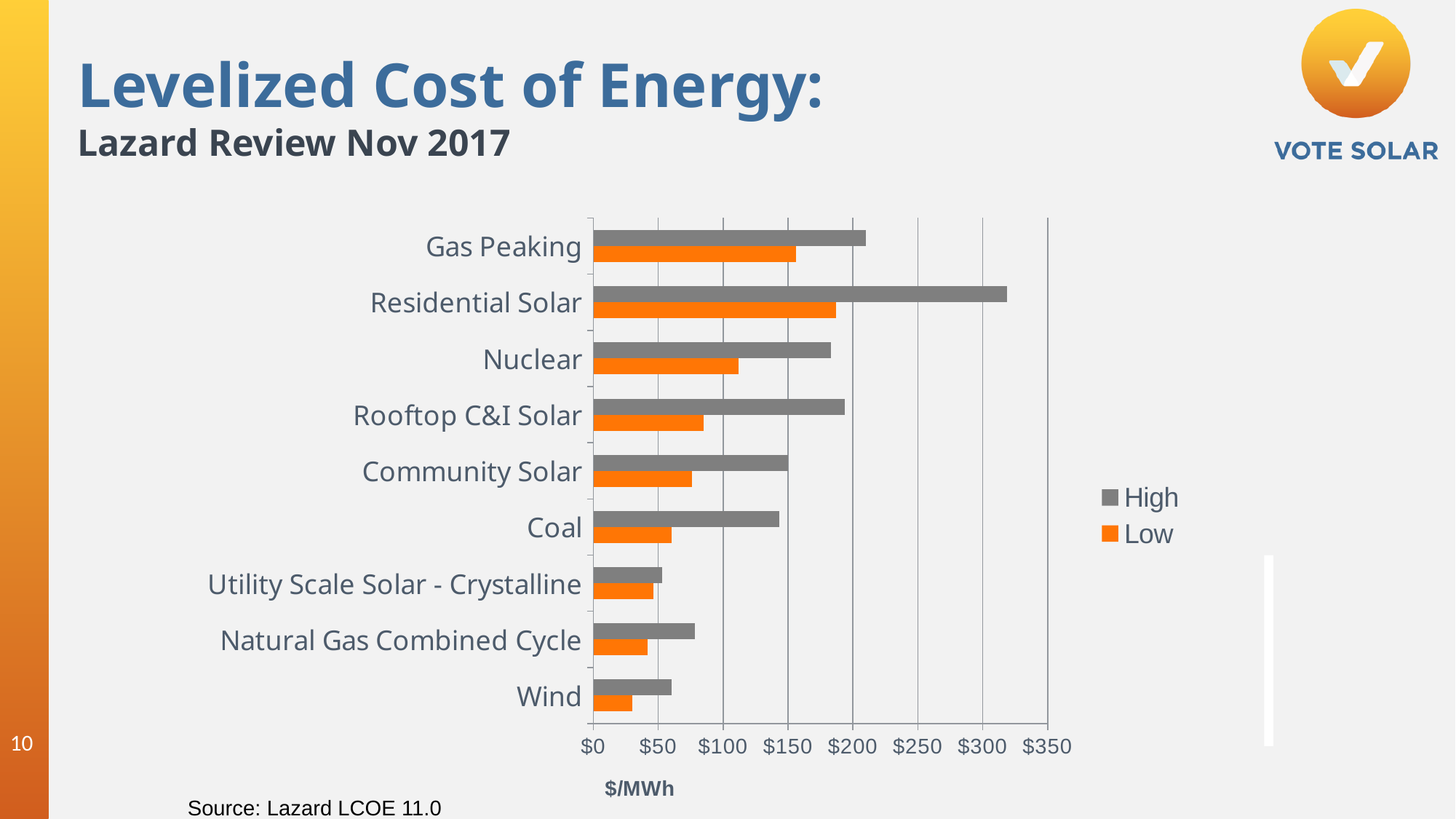
Is the Low value for Rooftop C&I Solar greater or less than $100? less Is the High value for Residential Solar greater or less than $300? greater How many series does the legend list? 2 Which category has the highest Low value? Residential Solar Which is larger, the Low value for Gas Peaking or the Low value for Nuclear? Gas Peaking Which category has the highest High value? Residential Solar How many energy categories are plotted on the chart? 9 What unit is shown on the horizontal axis label? $/MWh Is the Low value for Wind greater or less than $50? less Which category has the lowest Low value? Wind What kind of chart is shown on the slide? Bar chart